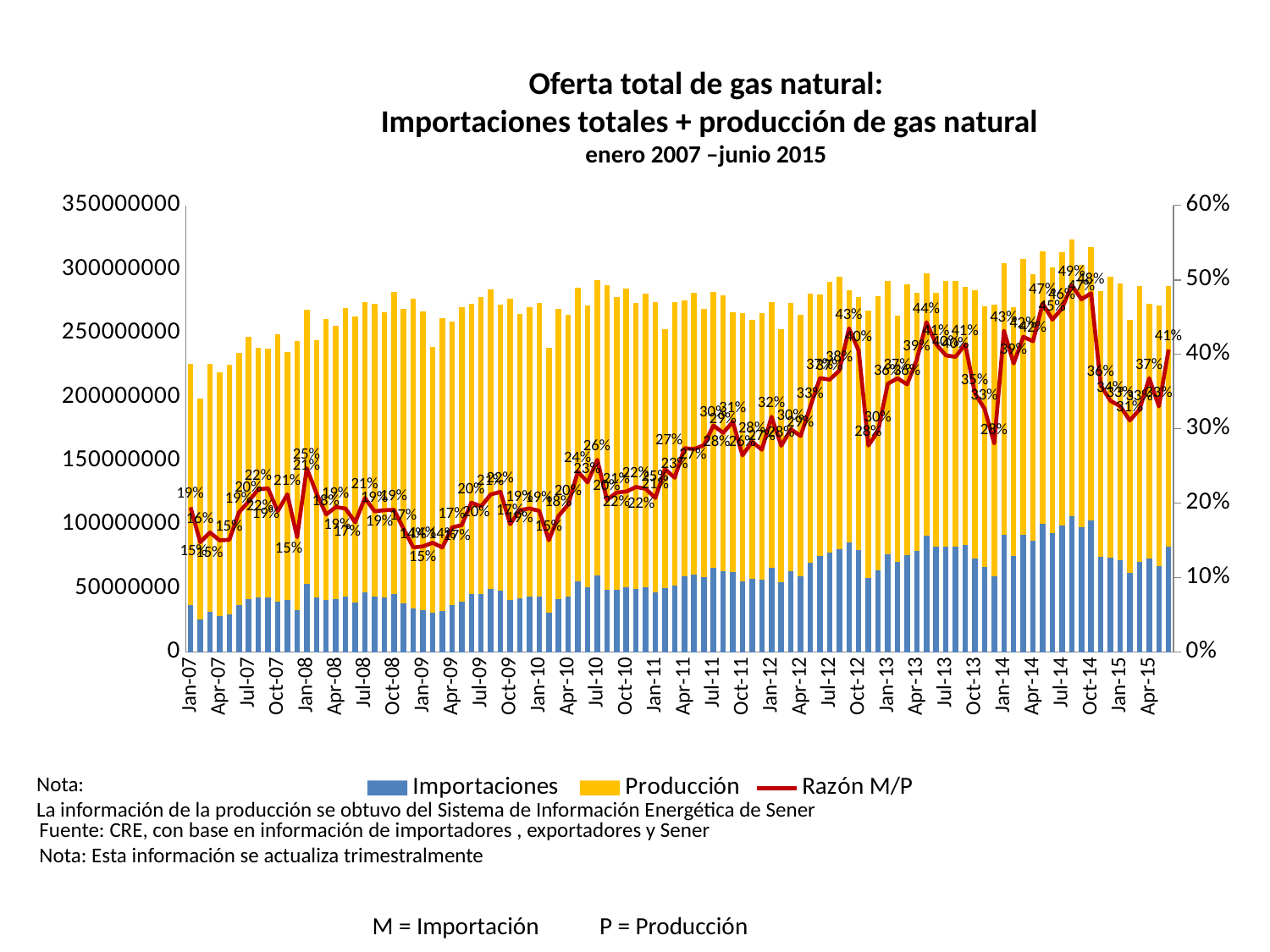
At Jan-07, which is larger, Importaciones or Producción? Producción What period does the chart cover according to its subtitle? enero 2007 – junio 2015 Is the Importaciones value at Jan-14 greater or less than 50000000? greater What is the highest Razón M/P value labelled on the line? 49% How many series does the legend list? 3 What is the Razón M/P value labelled at Jan-07, the first point of the line? 19% Over the whole period, does the Razón M/P line generally rise or fall? rise What is the Razón M/P value labelled at the last point of the line (Jun-15)? 41% Is the Importaciones value at Jan-07 greater or less than 50000000? less Is the Razón M/P value at Jan-07 greater or less than 30%? less What kind of chart is shown on the slide? A combined bar and line chart (stacked bars with a line) Which series is plotted as a line rather than as bars? Razón M/P